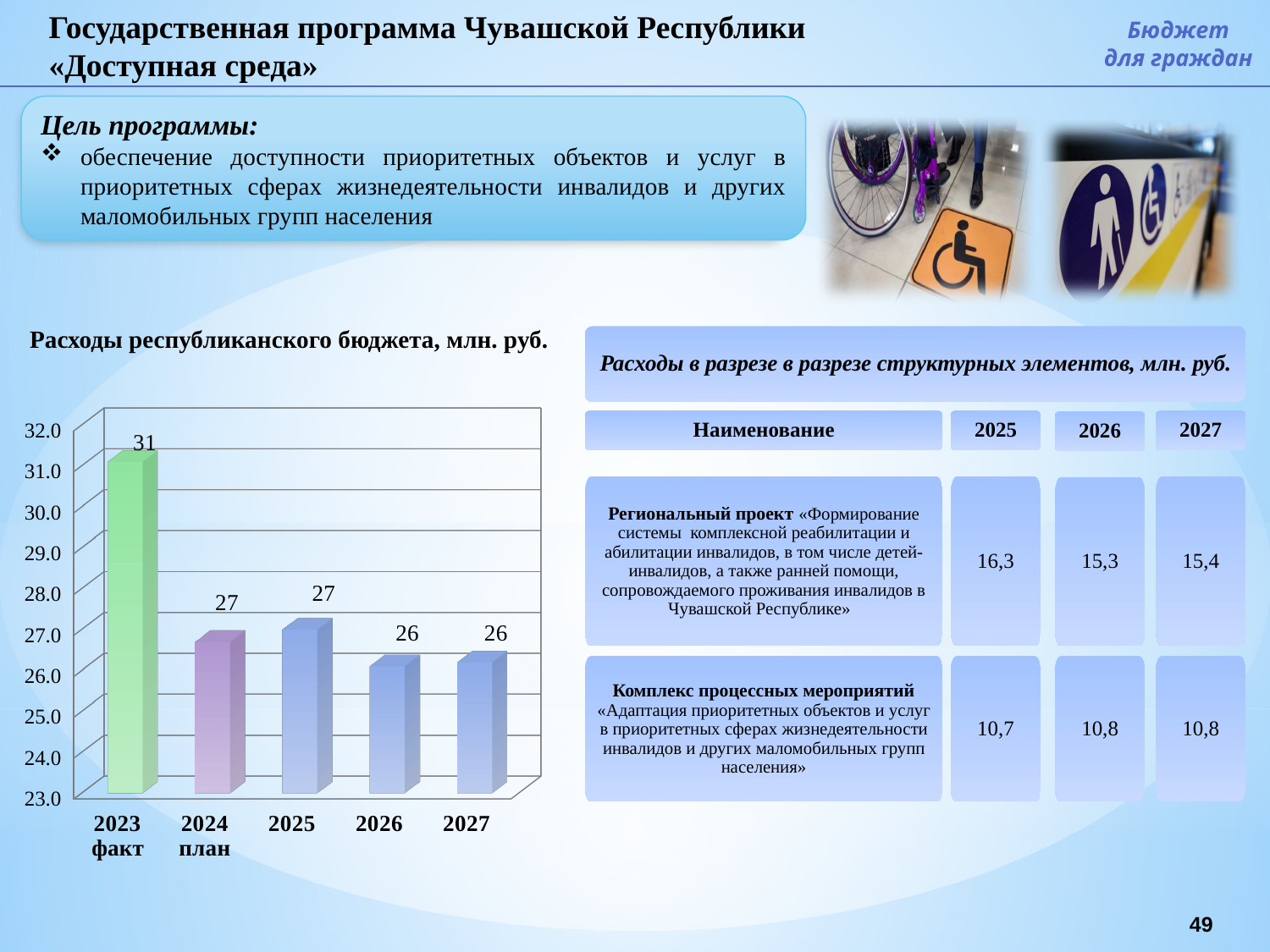
What is the value for 2027 in the chart? 26 What is the value for 2026 in the chart? 26 What is the difference between the values for 2023 факт and 2024 план? 4 What is the value for 2024 план in the chart? 27 Is the value for 2023 факт greater or less than 30.0? greater Which category has the highest value in the chart? 2023 факт Do the values in the chart generally rise or fall from 2023 to 2027? fall What is the difference between the values for 2025 and 2026? 1 Which is larger, the value for 2023 факт or the value for 2025? 2023 факт What kind of chart is shown on the slide? bar chart How many categories are shown on the x axis of the chart? 5 What is the value for 2023 факт in the chart 'Расходы республиканского бюджета, млн. руб.'? 31